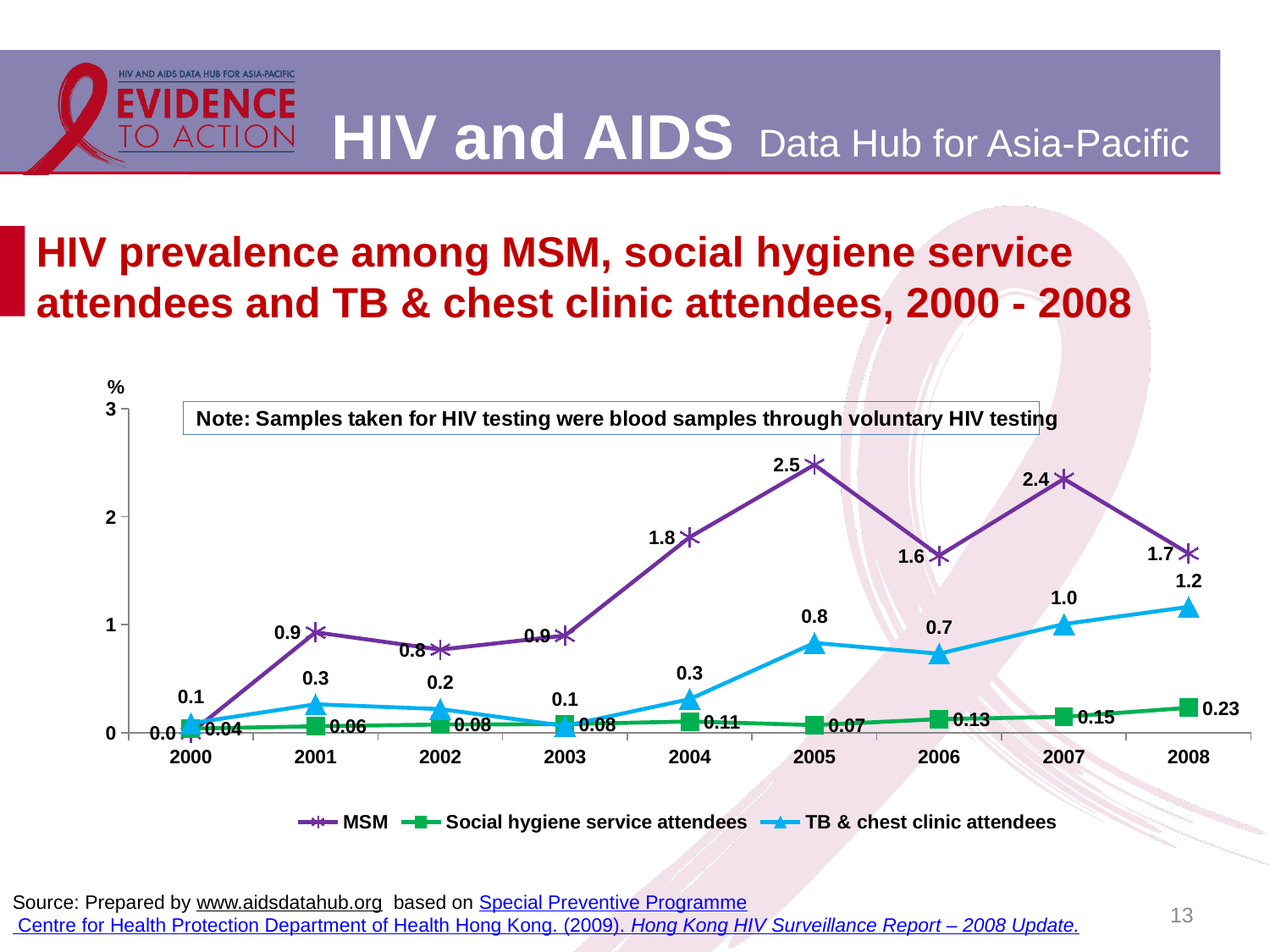
What is the value for social hygiene service attendees in 2007? 0.15 What is the HIV prevalence among MSM in 2005? 2.5 Which is larger in 2007: the value for MSM or the value for TB & chest clinic attendees? MSM In which year is the value for social hygiene service attendees lowest? 2000 In which year is the MSM series at its highest? 2005 Is the MSM value in 2004 greater or less than 1? greater How many series does the legend list? 3 Does the value for social hygiene service attendees rise or fall from 2006 to 2008? Rise What is the difference between the MSM values in 2005 and 2006? 0.9 How many years are shown on the x axis? 9 What is the value for TB & chest clinic attendees in 2008? 1.2 What kind of chart is shown on the slide? Line chart